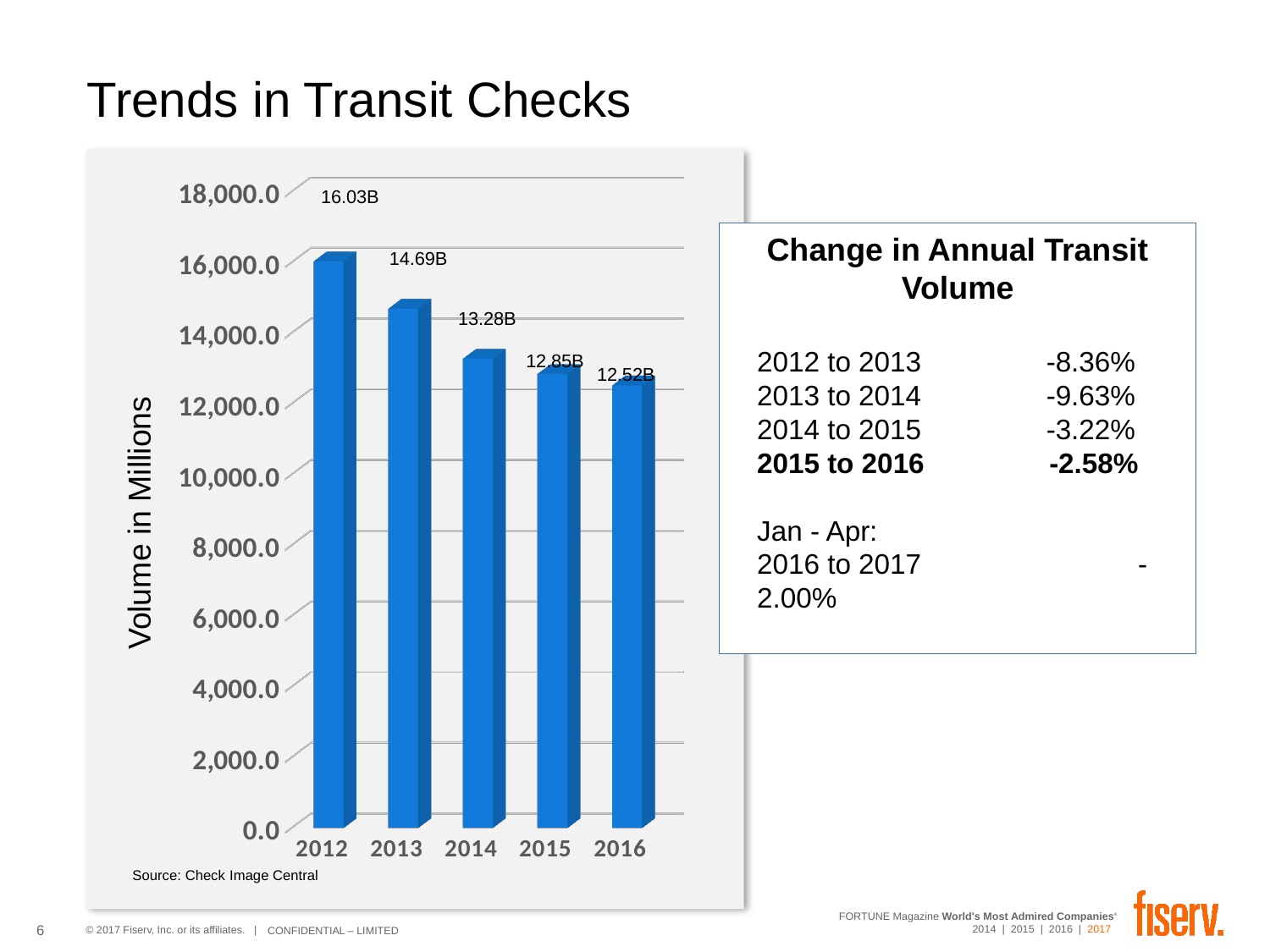
Do the values rise or fall from 2012 to 2016? fall Which year has the highest transit check volume? 2012 Which is larger, the value for 2013 or the value for 2014? 2013 Is the value for 2015 greater or less than 14,000.0 on the y axis? less How many years are shown on the x axis? 5 Which year has the lowest transit check volume? 2016 What is the difference between the 2015 and 2016 data labels? 0.33B What is the data label for 2016? 12.52B What is the difference between the 2012 and 2013 data labels? 1.34B What is the data label for 2014? 13.28B What kind of chart is shown on the slide? bar chart What is the data label for 2012? 16.03B